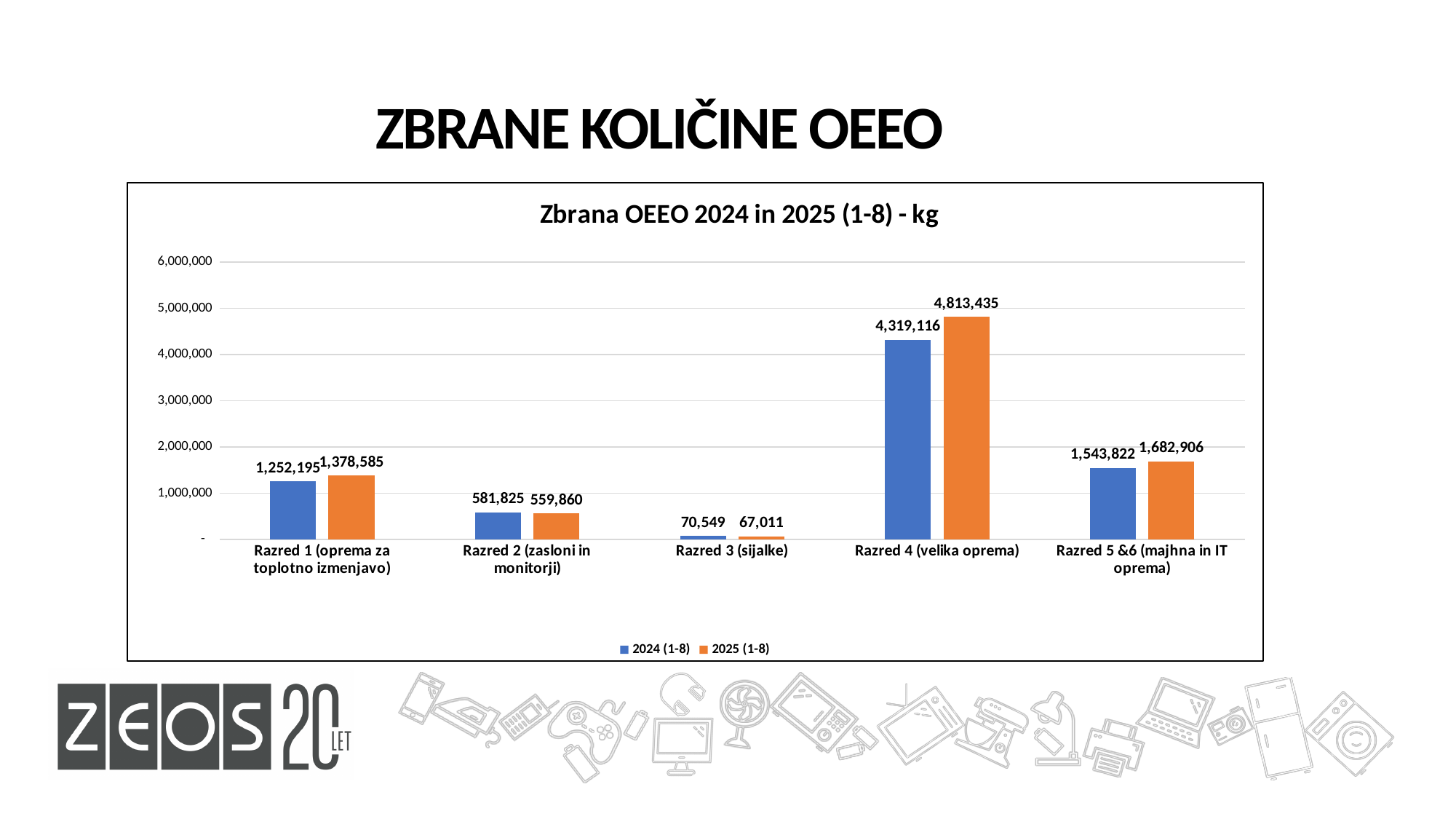
How many categories are shown on the x axis? 5 Is the 2025 (1-8) value for Razred 5 &6 (majhna in IT oprema) greater or less than 2,000,000? less What is the 2025 (1-8) value for Razred 1 (oprema za toplotno izmenjavo)? 1,378,585 How many series does the legend list? 2 For Razred 2 (zasloni in monitorji), which is larger: the 2024 (1-8) value or the 2025 (1-8) value? 2024 (1-8) What type of chart is shown on the slide? bar chart What is the 2024 (1-8) value for Razred 4 (velika oprema)? 4,319,116 What is the difference between the 2025 (1-8) and 2024 (1-8) values for Razred 4 (velika oprema)? 494,319 Which category has the highest 2025 (1-8) value? Razred 4 (velika oprema) Which category has the lowest 2024 (1-8) value? Razred 3 (sijalke) What is the title of the chart? Zbrana OEEO 2024 in 2025 (1-8) - kg What is the 2025 (1-8) value for Razred 3 (sijalke)? 67,011